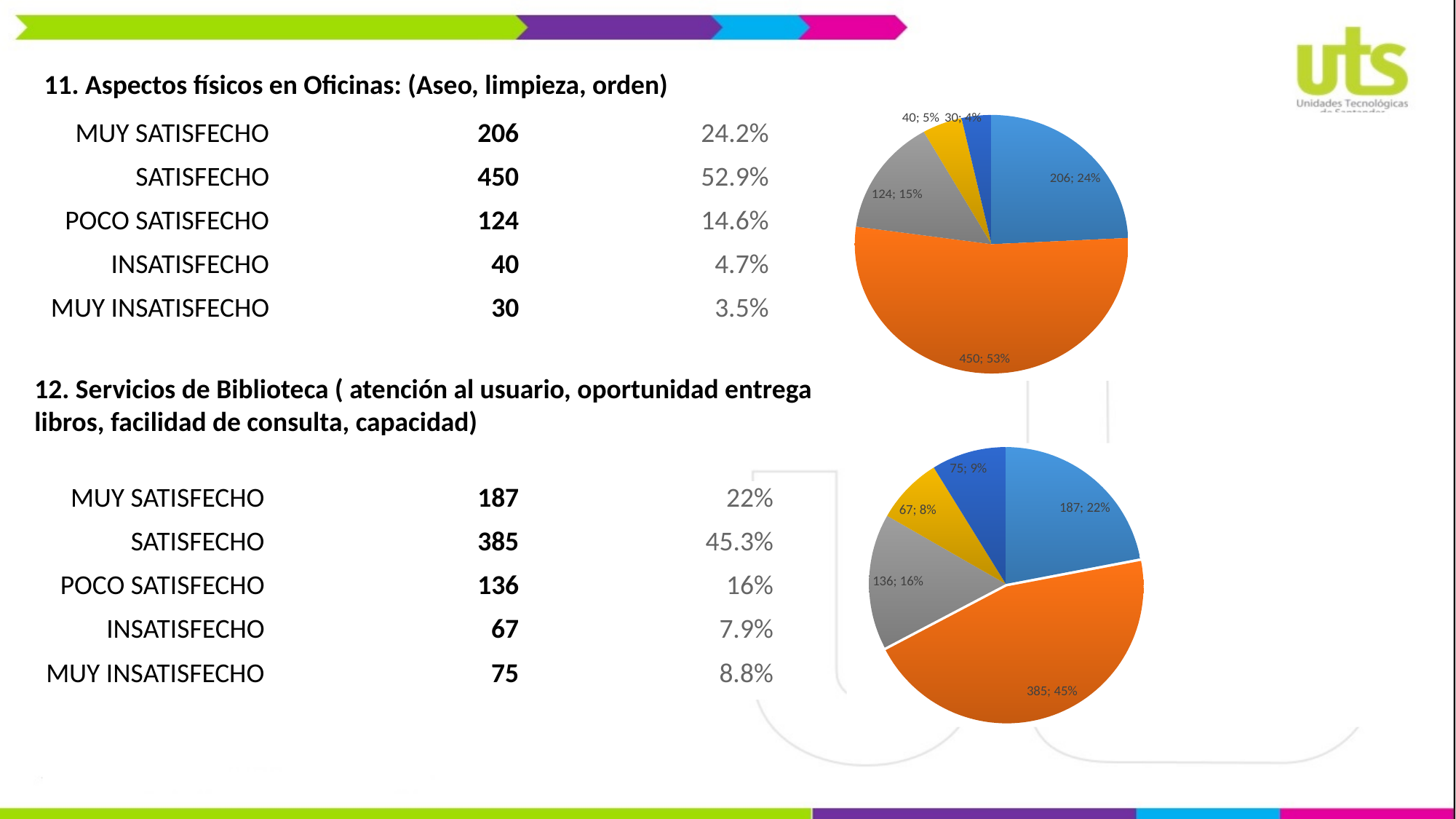
In the top pie chart (Aspectos físicos en Oficinas), which category has the largest slice? SATISFECHO In the bottom pie chart (Servicios de Biblioteca), what colour is the largest slice? Orange What kind of chart is used for item 11, Aspectos físicos en Oficinas? Pie chart In the top pie chart (Aspectos físicos en Oficinas), what value is shown for the largest slice? 450; 53% In the bottom pie chart (Servicios de Biblioteca), what value is shown for the MUY SATISFECHO slice? 187; 22% In the top pie chart (Aspectos físicos en Oficinas), what share of the pie does the POCO SATISFECHO slice represent? 15% In the bottom pie chart (Servicios de Biblioteca), which is larger, the INSATISFECHO slice or the MUY INSATISFECHO slice? MUY INSATISFECHO How many slices does the top pie chart (Aspectos físicos en Oficinas) have? 5 In the bottom pie chart (Servicios de Biblioteca), which category has the largest slice? SATISFECHO In the bottom pie chart (Servicios de Biblioteca), what share of the pie does the SATISFECHO slice represent? 45% In the top pie chart (Aspectos físicos en Oficinas), what is the difference between the SATISFECHO count and the MUY SATISFECHO count? 244 In the top pie chart (Aspectos físicos en Oficinas), which category has the smallest slice? MUY INSATISFECHO